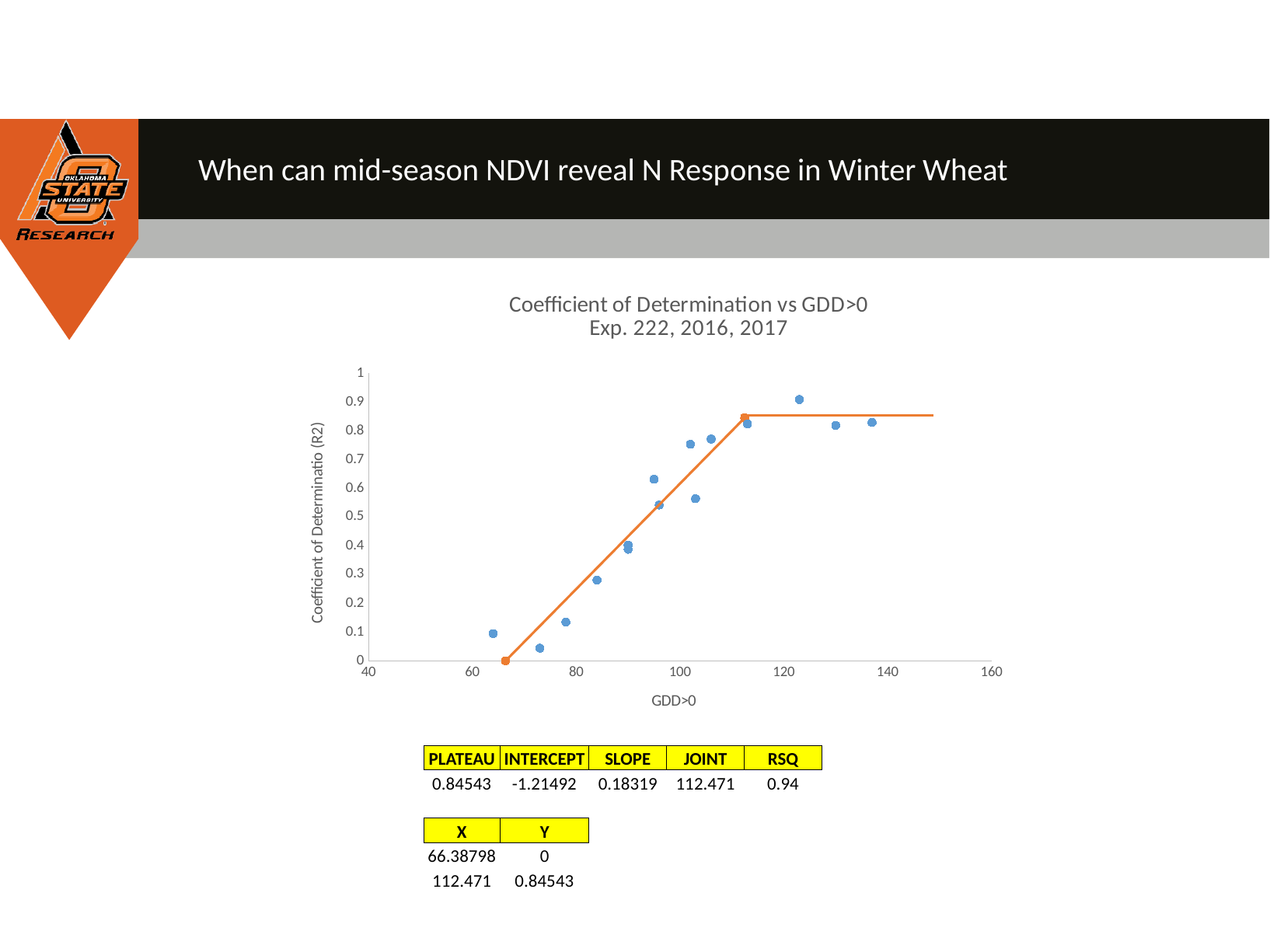
Is the R2 value of the highest plotted point (near GDD>0 of 123) greater or less than 0.8? greater Which has the higher R2 value: the point near GDD>0 of 123 or the point near GDD>0 of 73? The point near GDD>0 of 123 Is the R2 value of the leftmost plotted point (near GDD>0 of 64) greater or less than 0.2? less Is the R2 value of the point near GDD>0 of 84 greater or less than 0.4? less According to the table below the chart, what is the RSQ value of the fit? 0.94 According to the table below the chart, what is the JOINT value of the fitted line? 112.471 What kind of chart is shown on the slide? Scatter chart Do the plotted R2 values generally rise or fall as GDD>0 increases from 60 to 120? Rise According to the table below the chart, what is the PLATEAU value of the fitted line? 0.84543 What is the label on the x axis of the chart? GDD>0 According to the X/Y table below the chart, at what X value does the fitted line reach Y = 0? 66.38798 What is the title of the chart? Coefficient of Determination vs GDD>0 Exp. 222, 2016, 2017